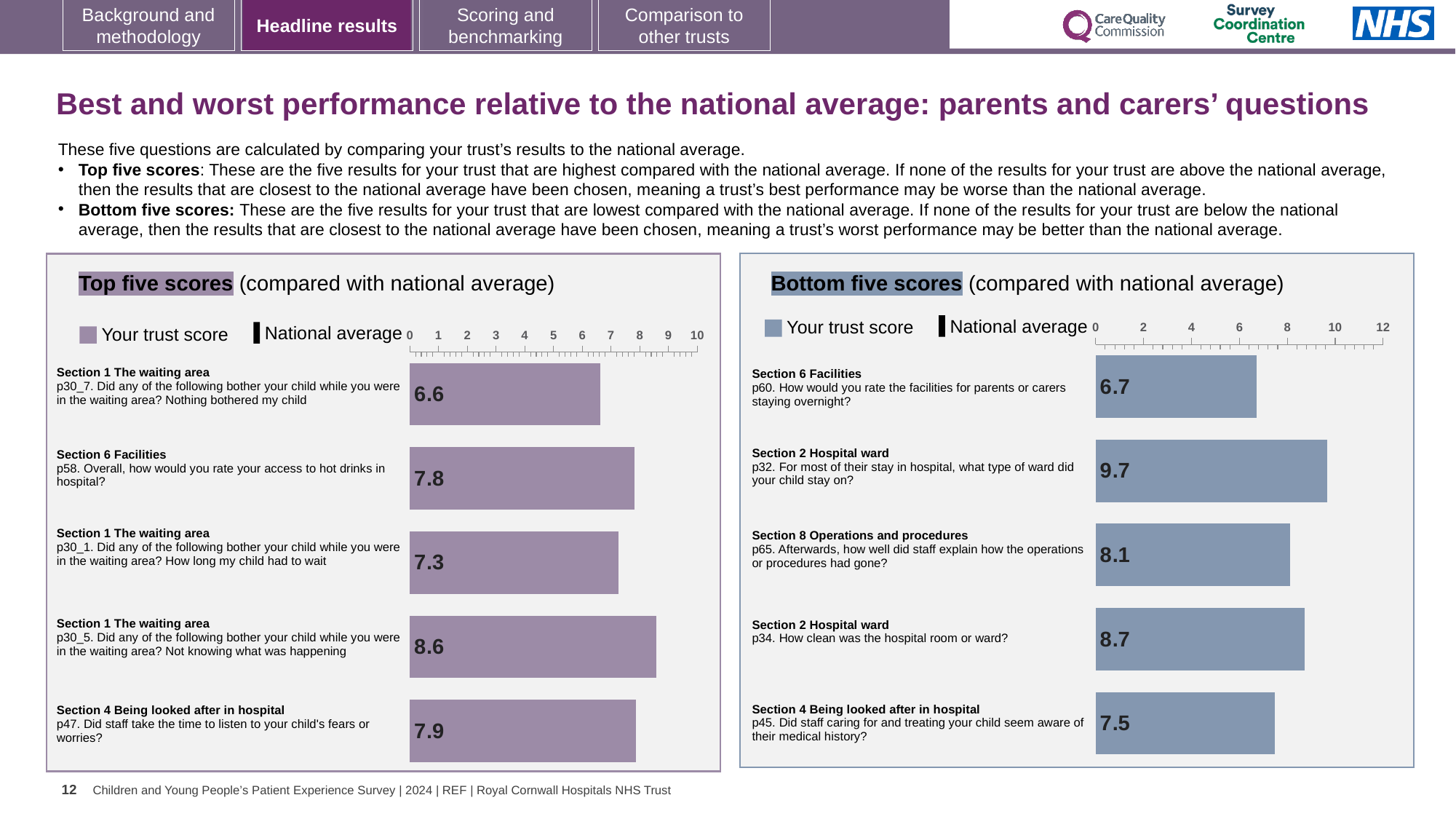
What type of chart is the Bottom five scores chart? Bar chart How many questions are plotted in the Bottom five scores chart? 5 In the Top five scores chart, which has the larger trust score: p47 or p30_1? p47 In the Top five scores chart, what is the trust score for p30_5 (Not knowing what was happening)? 8.6 In the Bottom five scores chart, what is the difference between the trust scores for p32 and p60? 3.0 In the Bottom five scores chart, what is the trust score for p45 (staff aware of their medical history)? 7.5 In the Top five scores chart, which question has the lowest trust score? p30_7. Did any of the following bother your child while you were in the waiting area? Nothing bothered my child In the Bottom five scores chart, what is the trust score for p32 (type of ward your child stayed on)? 9.7 In the Top five scores chart, which question has the highest trust score? p30_5. Did any of the following bother your child while you were in the waiting area? Not knowing what was happening In the Bottom five scores chart, which question has the lowest trust score? p60. How would you rate the facilities for parents or carers staying overnight? How many series does the legend of the Top five scores chart list? 2 In the Top five scores chart, what is the trust score for p58 (access to hot drinks in hospital)? 7.8